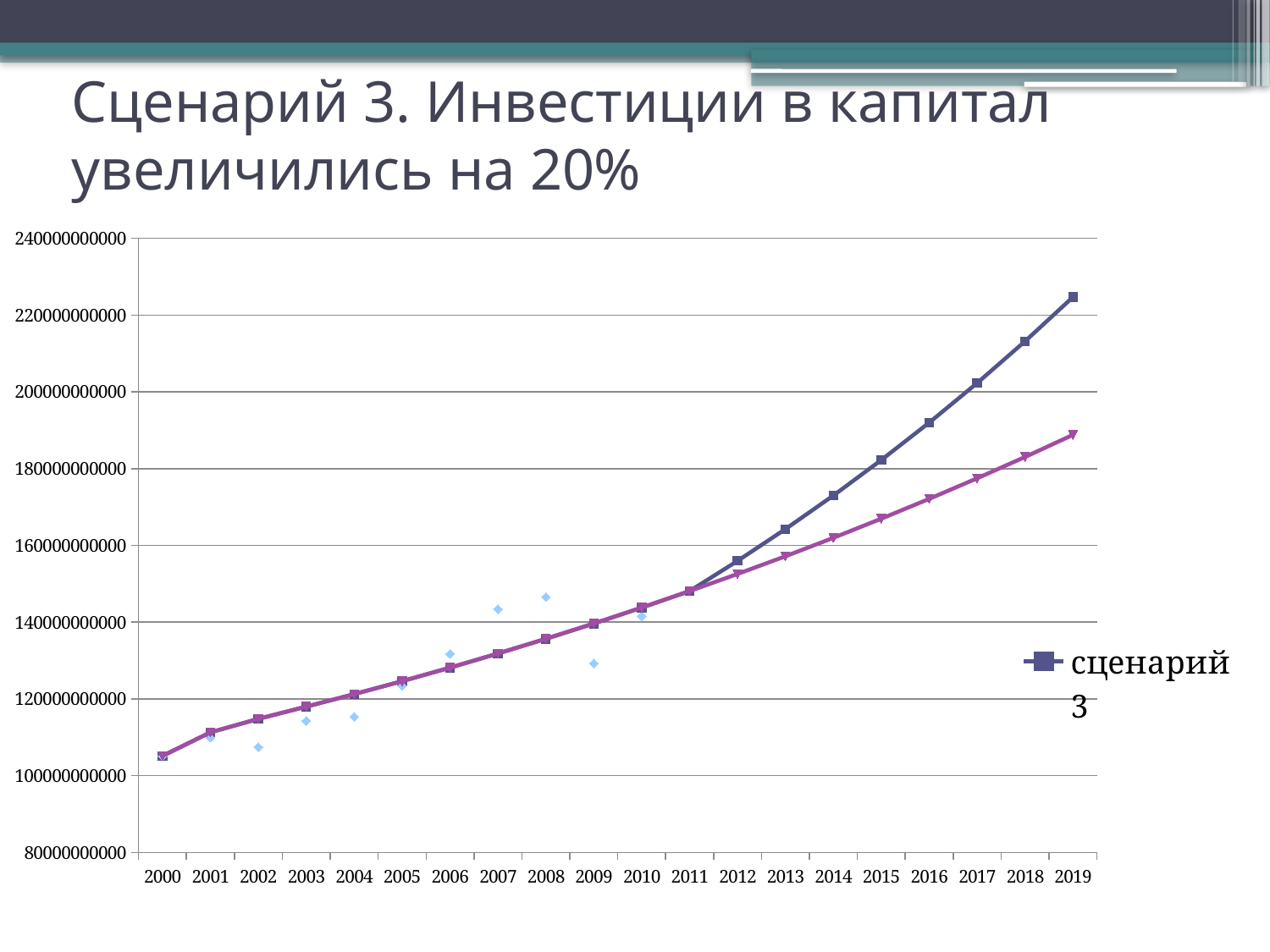
Is the value of сценарий 3 in 2019 greater or less than 220000000000? greater In 2019, which is higher: the сценарий 3 line with square markers or the line with triangle markers? сценарий 3 In which year is the value of сценарий 3 lowest? 2000 Is the value of сценарий 3 in 2012 greater or less than 160000000000? less Does the value of сценарий 3 rise or fall from 2000 to 2019? rise Is the value of сценарий 3 in 2016 greater or less than 200000000000? less What is the name of the series listed in the chart's legend? сценарий 3 How many series does the chart's legend list? 1 What kind of chart is shown on the slide? line chart How many years are shown along the x axis of the chart? 20 In which year is the value of сценарий 3 highest? 2019